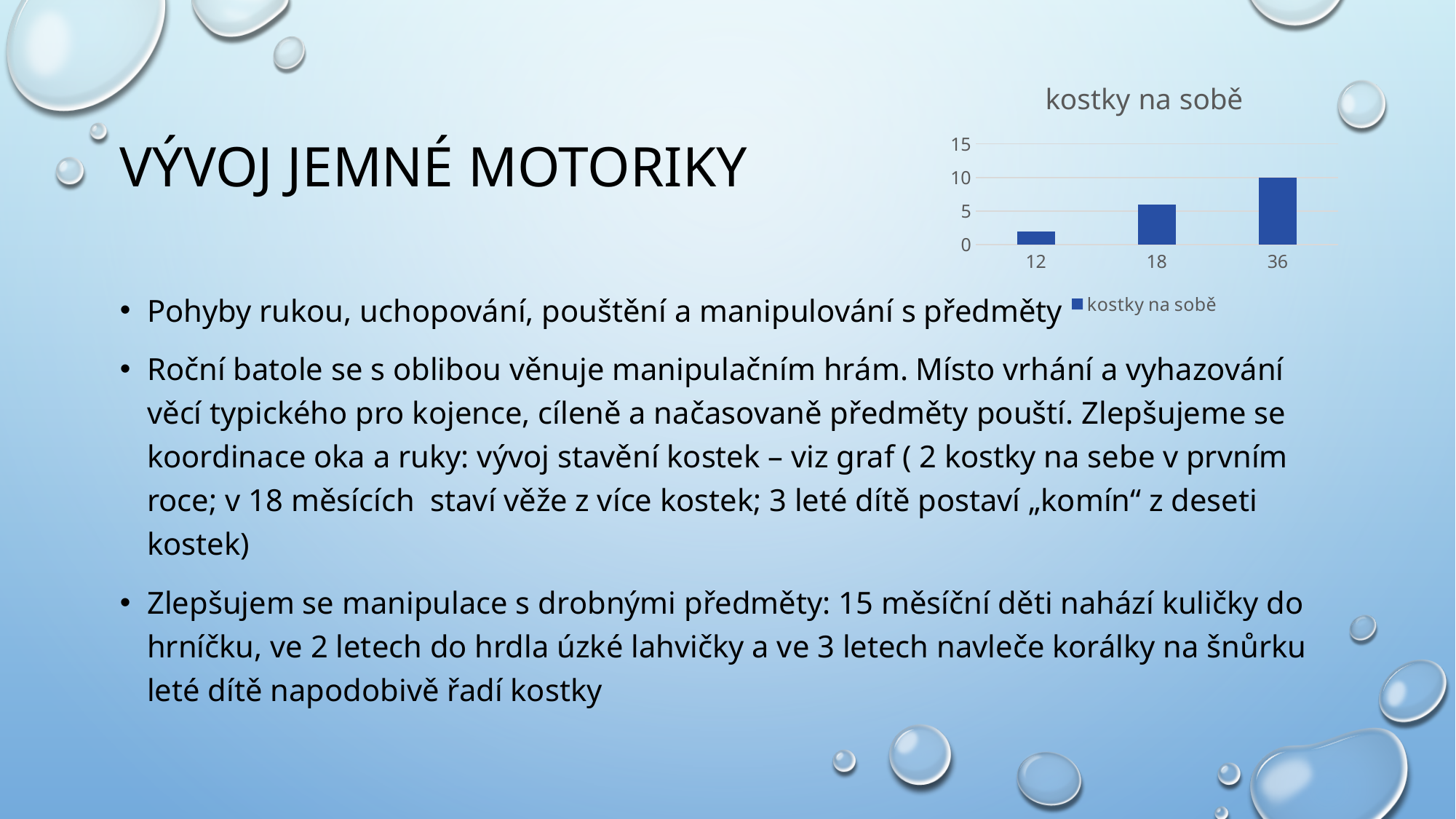
Which has the larger value, category 12 or category 18? 18 Is the value for category 12 greater or less than 5? less What is the title of the chart? kostky na sobě Is the value for category 18 greater or less than 5? greater Which category has the lowest bar in the chart? 12 How many series does the chart legend list? 1 Which category has the highest bar in the chart? 36 What is the value for category 36 in the chart? 10 How many categories are shown on the x axis of the chart? 3 Do the values rise or fall from left to right along the x axis? rise What kind of chart is shown on the slide? bar chart Is the value for category 18 greater or less than 10? less